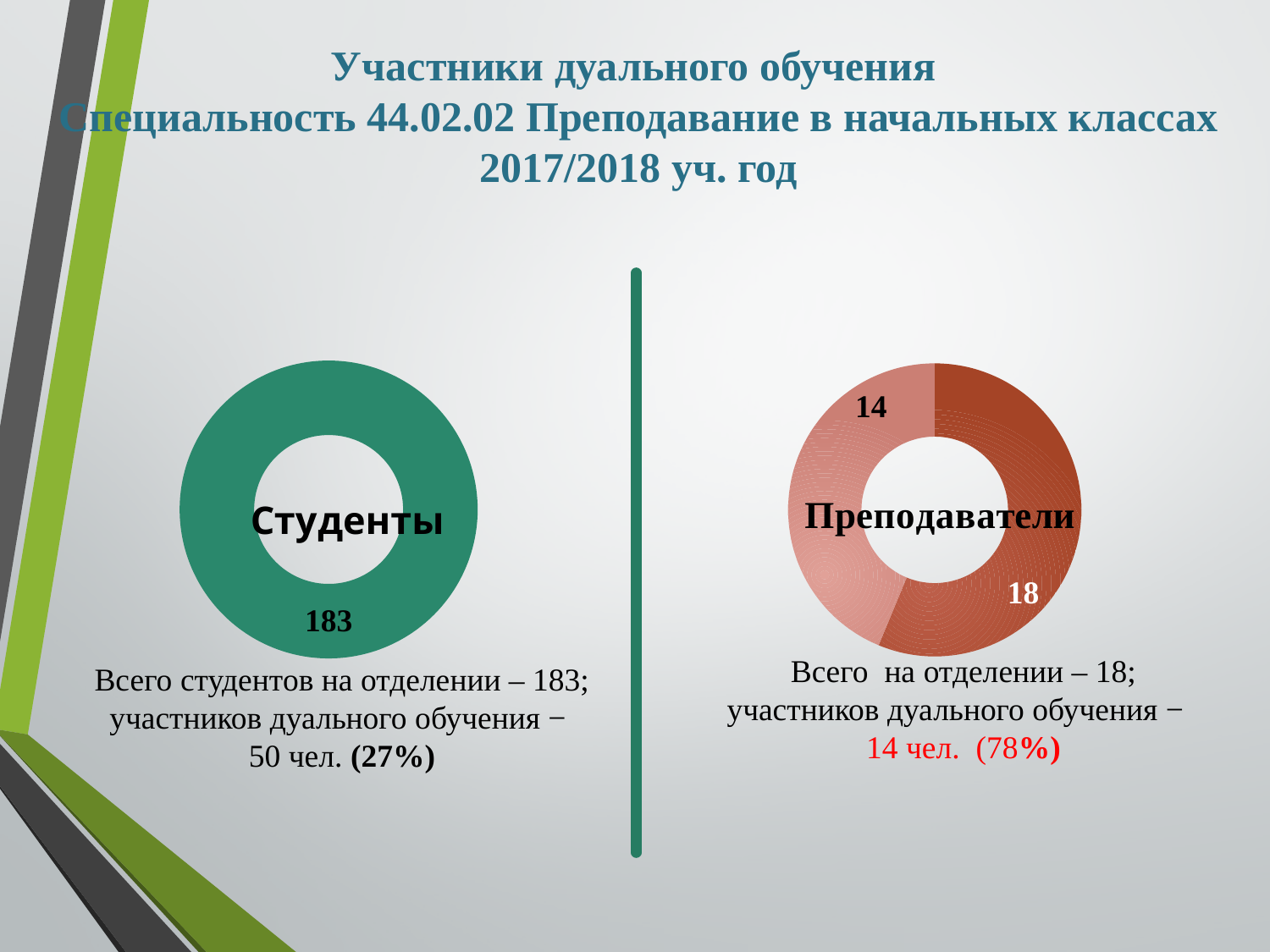
What kind of chart is the right chart labelled "Преподаватели"? doughnut (pie) chart What label is printed in the centre of the left doughnut chart? Студенты In the right chart "Преподаватели", what is the difference between the two slice values, 18 and 14? 4 How many slices does the left chart "Студенты" show? 1 In the right chart "Преподаватели", which slice has the smallest value? 14 In the right chart "Преподаватели", what value is printed on the lighter (smaller) slice? 14 How many slices does the right chart "Преподаватели" show? 2 In the right chart "Преподаватели", what value is printed on the darker (larger) slice? 18 In the right chart "Преподаватели", which slice is larger, the one labelled 18 or the one labelled 14? 18 In the left chart "Студенты", what value is printed on the ring? 183 What label is printed in the centre of the right doughnut chart? Преподаватели What kind of chart is the left chart labelled "Студенты"? doughnut (pie) chart